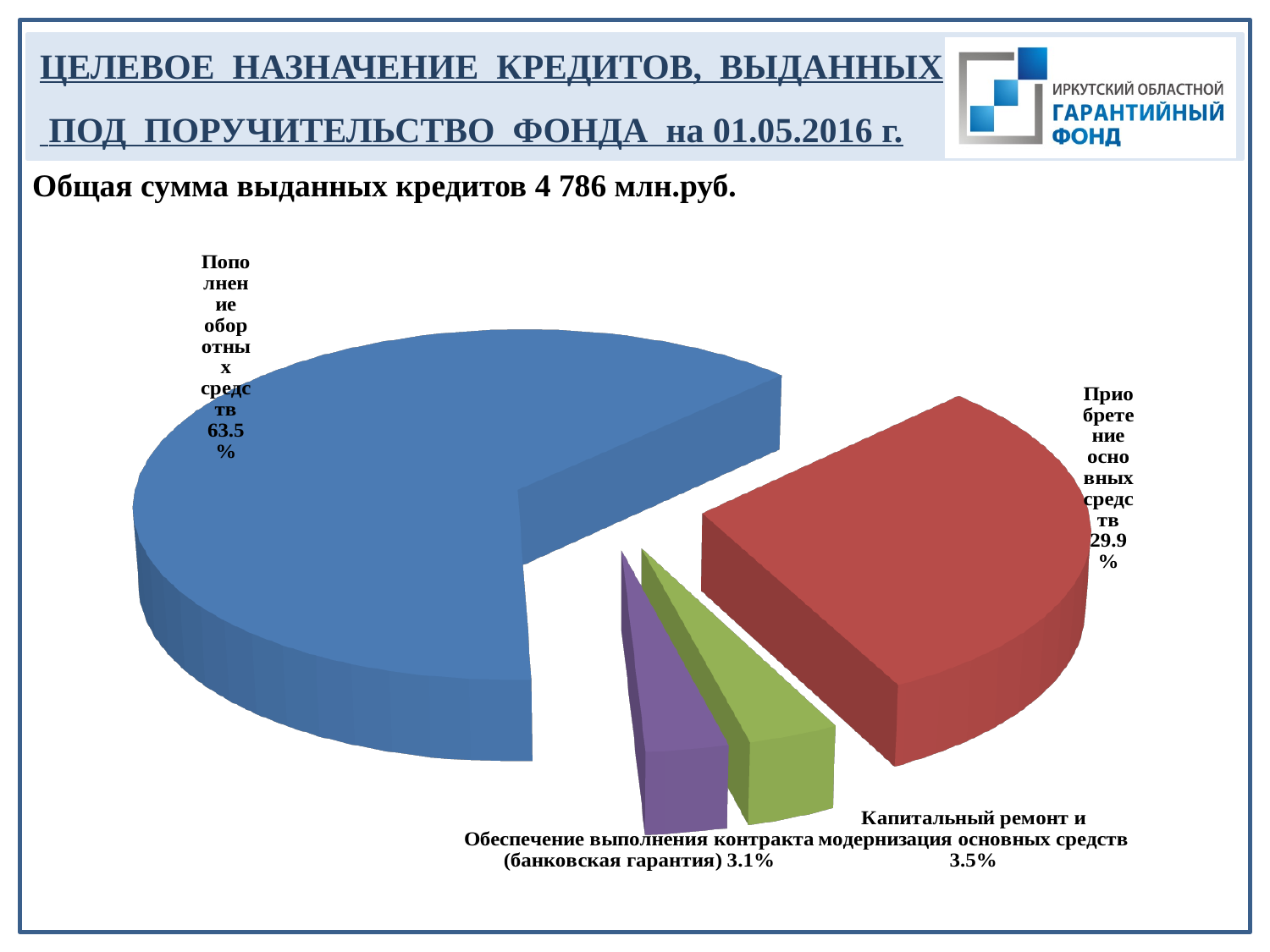
Which category has the smallest slice of the pie? Обеспечение выполнения контракта (банковская гарантия) What total sum of issued loans is stated above the chart? 4 786 млн.руб. What kind of chart is shown on the slide? Pie chart What share of the pie does "Пополнение оборотных средств" have? 63.5% Which is larger: the share for "Капитальный ремонт и модернизация основных средств" or for "Обеспечение выполнения контракта (банковская гарантия)"? Капитальный ремонт и модернизация основных средств How many slices does the pie chart have? 4 What share of the pie does "Капитальный ремонт и модернизация основных средств" have? 3.5% Which category has the largest slice of the pie? Пополнение оборотных средств What share of the pie does "Обеспечение выполнения контракта (банковская гарантия)" have? 3.1% What is the difference in percentage points between "Пополнение оборотных средств" and "Приобретение основных средств"? 33.6 What share of the pie does "Приобретение основных средств" have? 29.9% What colour is the slice for "Приобретение основных средств"? Red